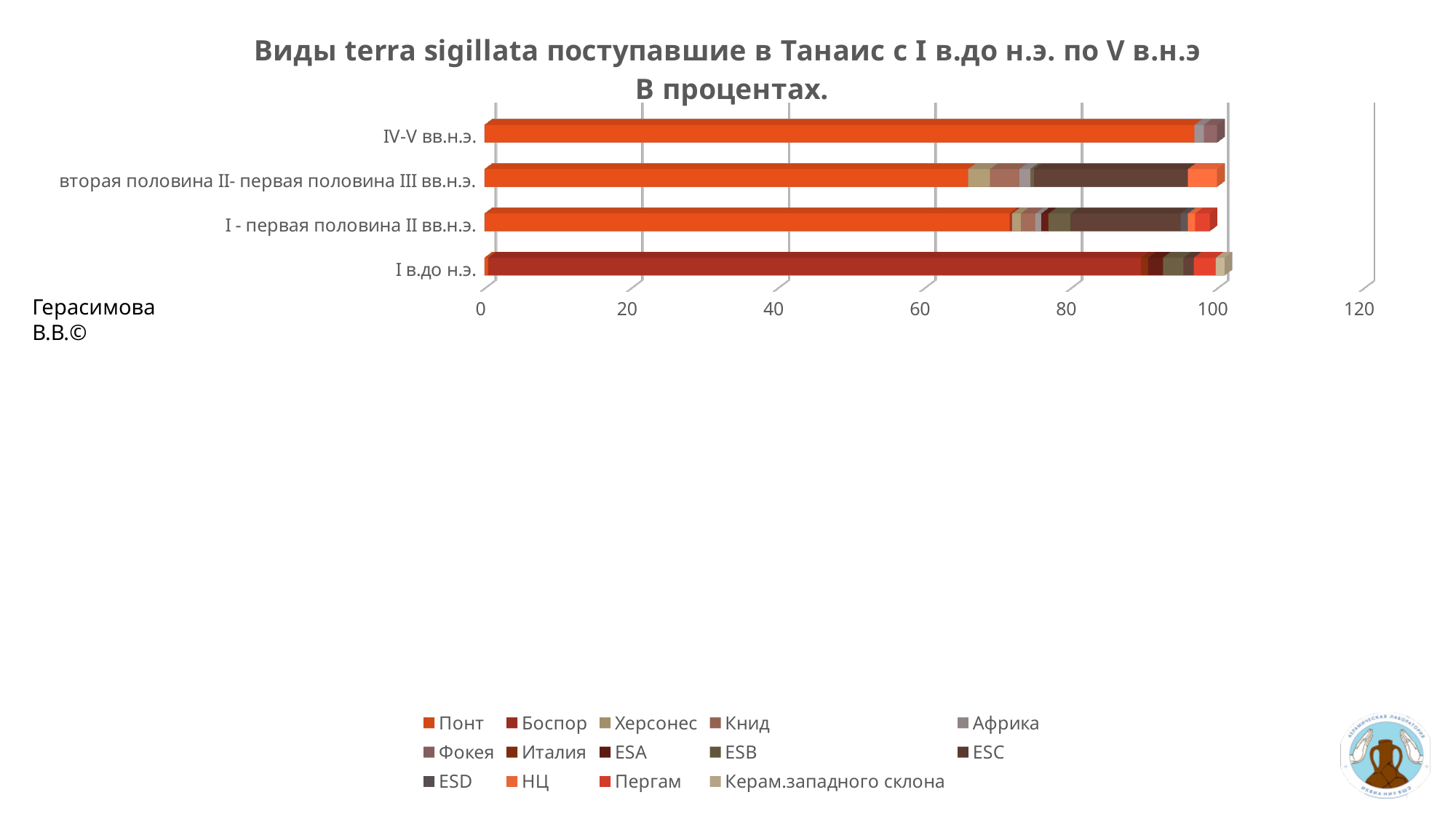
Is the value for Понт in the вторая половина II- первая половина III вв.н.э. period greater or less than 60? greater Is the value for Понт in the IV-V вв.н.э. period greater or less than 80? greater What kind of chart is shown on the slide? stacked bar chart Which is larger: the Понт value for IV-V вв.н.э. or the Понт value for вторая половина II- первая половина III вв.н.э.? IV-V вв.н.э. Is the value for Боспор in the I в.до н.э. period greater or less than 80? greater How many series does the legend list? 14 Which period has the largest share of Понт? IV-V вв.н.э. What is the highest tick value shown on the horizontal axis? 120 How many time periods (categories) are plotted on the chart? 4 Which series dominates the bar for I в.до н.э.? Боспор